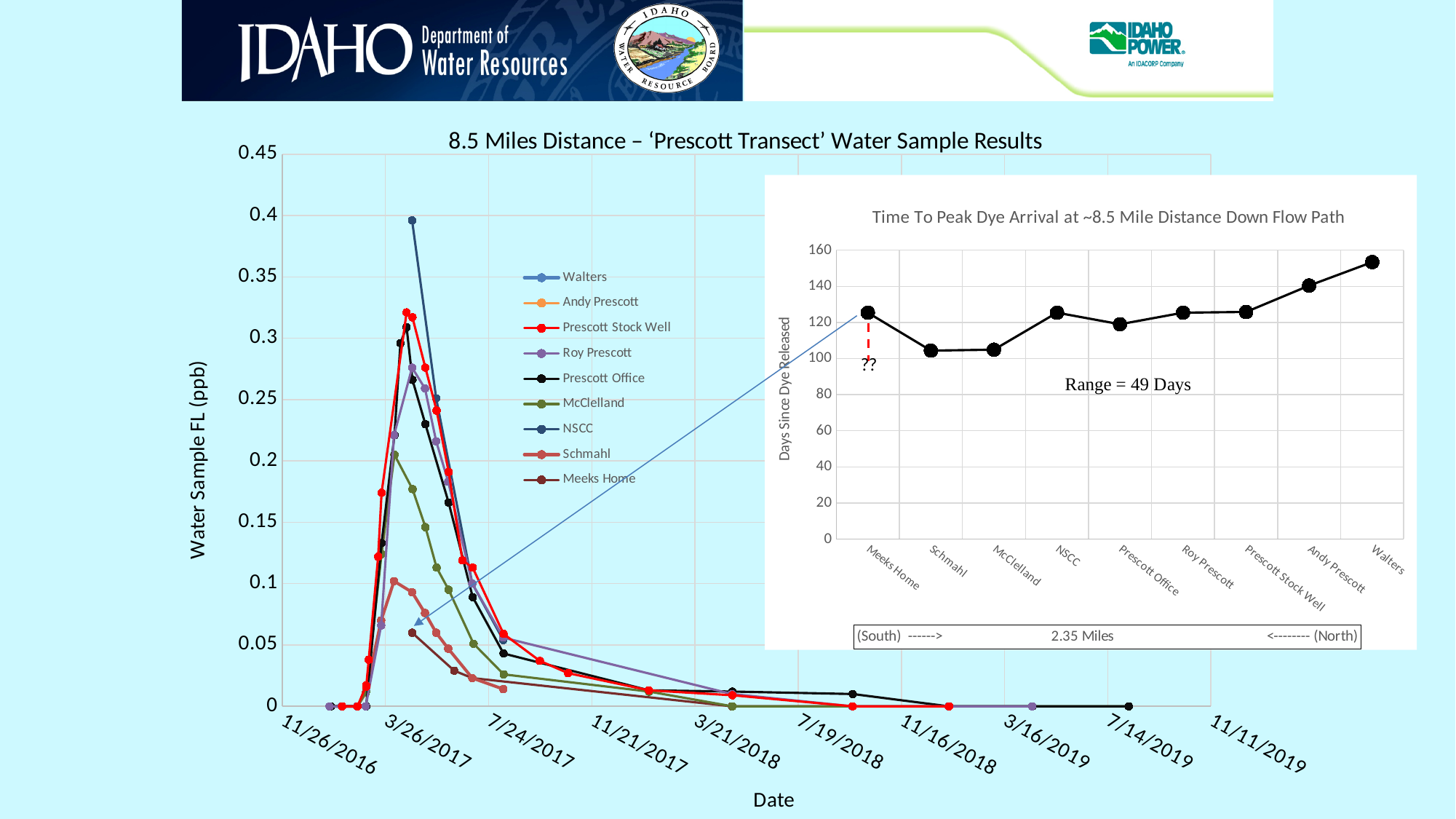
In the main '8.5 Miles Distance' chart, which series reaches the highest peak value? NSCC In the inset chart 'Time To Peak Dye Arrival', which category has the highest number of days since dye released? Walters In the main '8.5 Miles Distance' chart, is the peak value for NSCC greater or less than 0.35? greater According to the annotation on the inset chart 'Time To Peak Dye Arrival', what is the range of days? 49 Days How many categories are shown on the x axis of the inset chart 'Time To Peak Dye Arrival at ~8.5 Mile Distance Down Flow Path'? 9 In the main '8.5 Miles Distance' chart, which series has the larger peak value, NSCC or McClelland? NSCC How many series does the legend of the main '8.5 Miles Distance' chart list? 9 In the inset chart 'Time To Peak Dye Arrival', is the value for Schmahl greater or less than 120? less In the inset chart 'Time To Peak Dye Arrival', is the value for Walters greater or less than 140? greater What kind of chart is the main chart titled '8.5 Miles Distance – ‘Prescott Transect’ Water Sample Results'? line chart What is the y-axis label of the main '8.5 Miles Distance' chart? Water Sample FL (ppb)